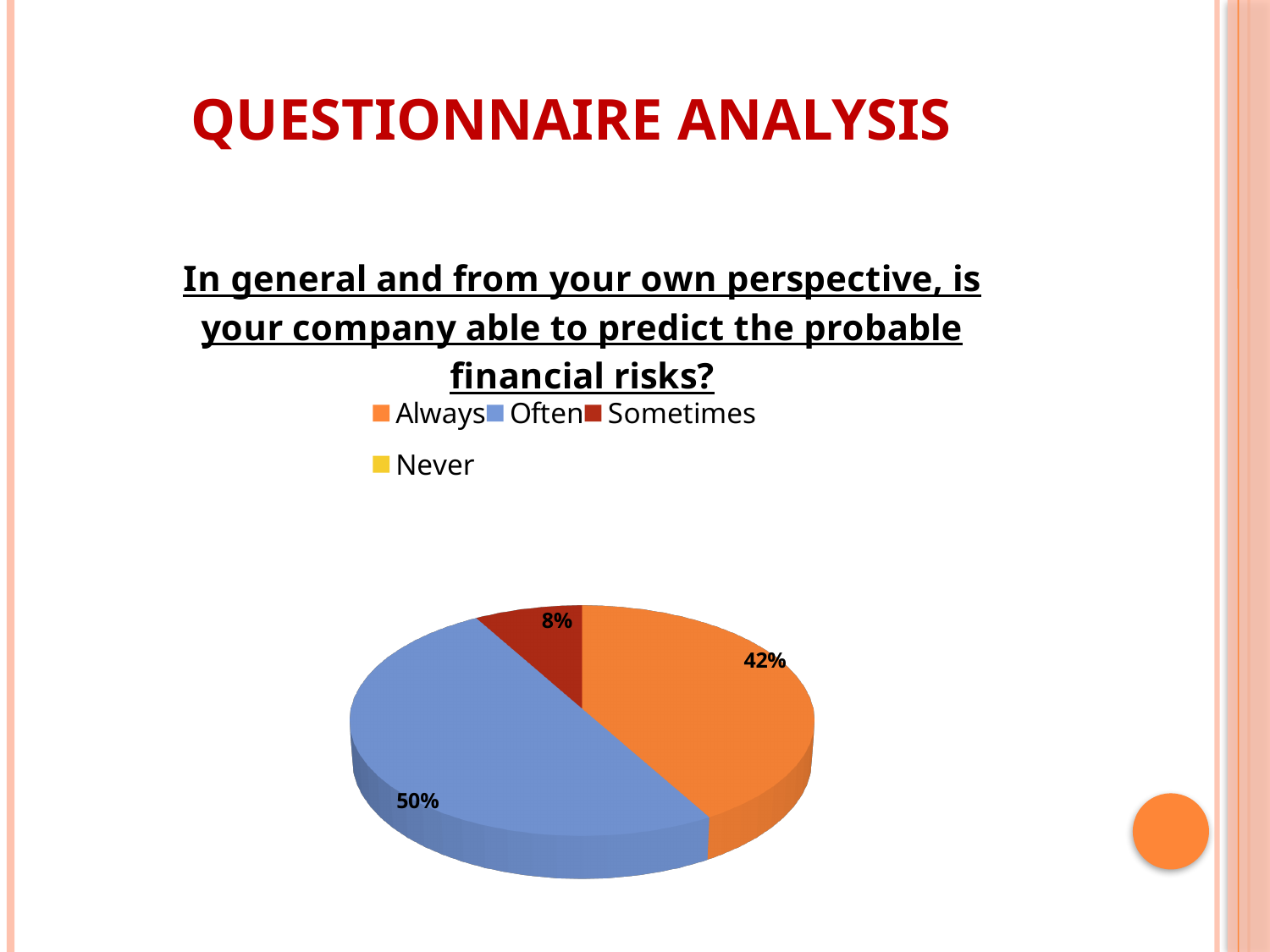
How many slices are visible in the pie? 3 What percentage of respondents answered "Often"? 50% What is the difference in percentage points between the "Always" and "Sometimes" slices? 34 What percentage of respondents answered "Sometimes"? 8% Which is larger, the share for "Always" or the share for "Sometimes"? Always What colour is the "Often" slice? Blue What kind of chart is shown on the slide? Pie chart Which response has the largest share of the pie? Often Which of the visible slices has the smallest share of the pie? Sometimes What is the difference in percentage points between the "Often" and "Always" slices? 8 How many entries does the legend list? 4 What percentage of respondents answered "Always"? 42%